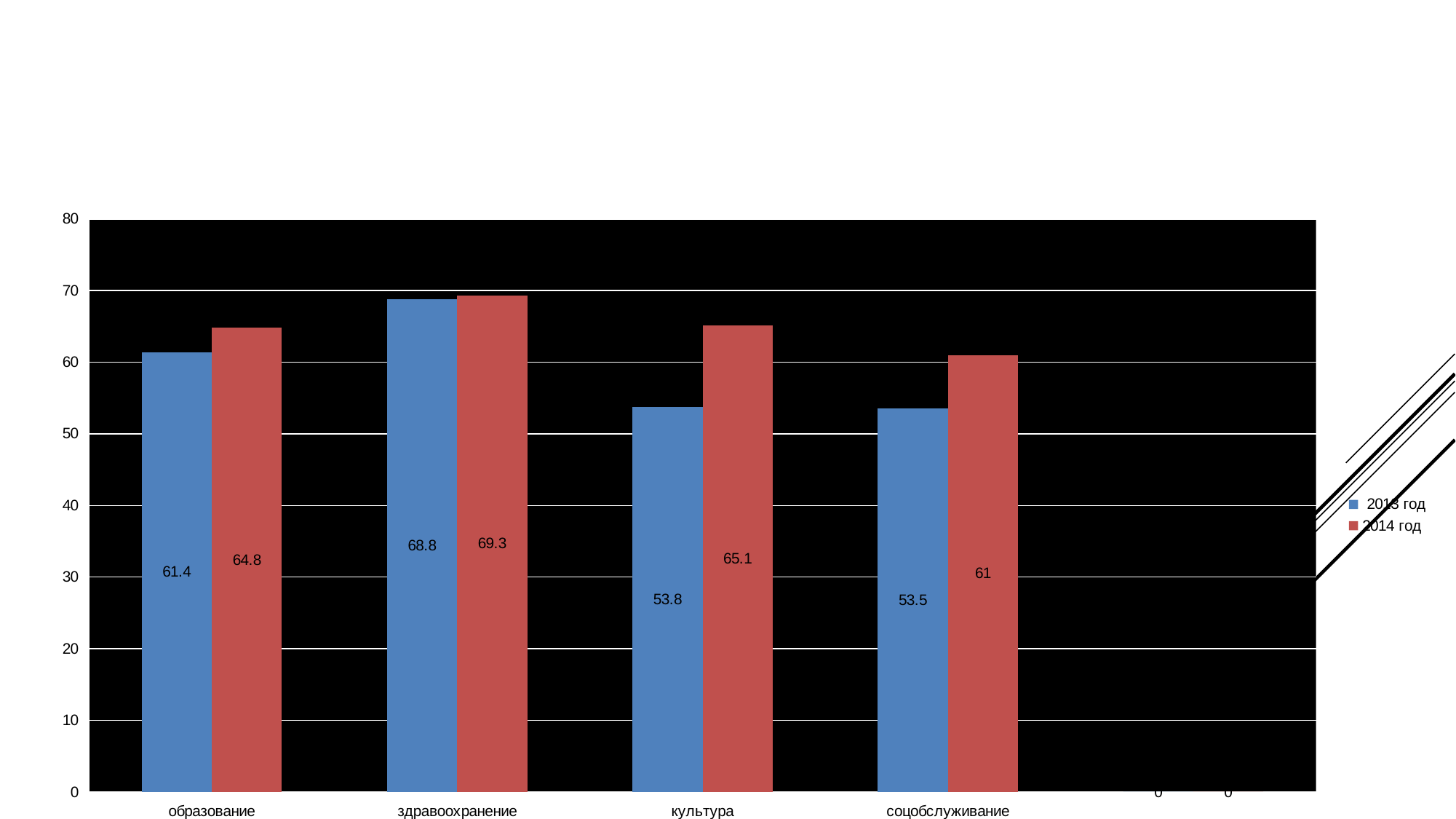
What is the difference between the 2014 год and 2013 год values for образование? 3.4 Which category has the lowest value in the 2013 год series? соцобслуживание Is the 2013 год value for культура greater or less than 60? less How many series does the legend list? 2 What is the value for соцобслуживание in the 2014 год series? 61 What is the difference between the 2014 год and 2013 год values for культура? 11.3 What is the value for здравоохранение in the 2013 год series? 68.8 What kind of chart is shown on the slide? bar chart What is the value for культура in the 2014 год series? 65.1 Which category has the highest value in the 2014 год series? здравоохранение Which is larger for соцобслуживание: the 2013 год value or the 2014 год value? 2014 год What is the value for образование in the 2013 год series? 61.4